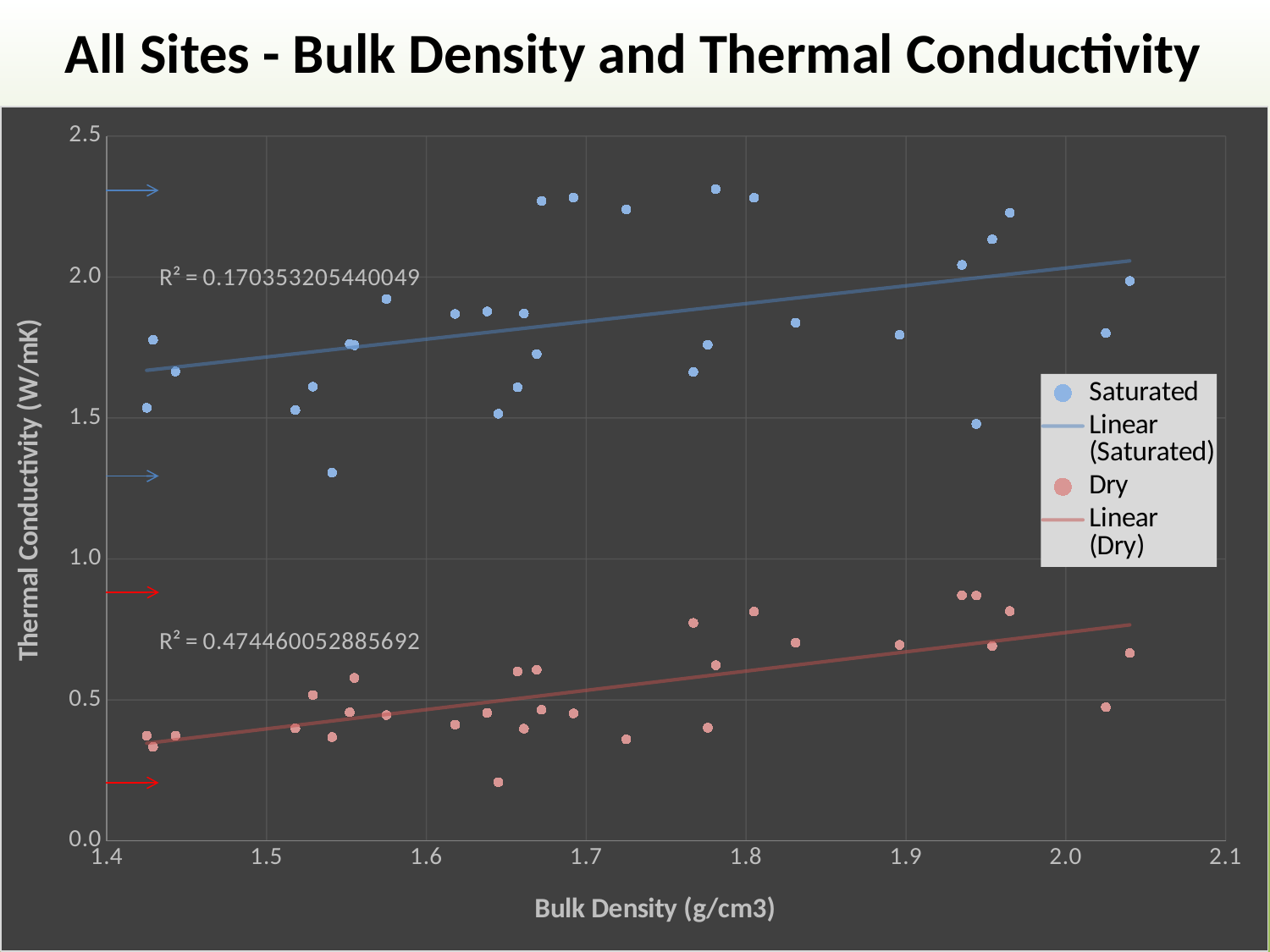
What is the title of the chart's x axis? Bulk Density (g/cm3) Which series has the higher R² value, Saturated or Dry? Dry What is the R² value shown for the Dry trendline? 0.474460052885692 Does the Linear (Saturated) trendline rise or fall as bulk density increases? Rises Is the lowest Dry thermal conductivity value greater or less than 0.5? less What is the R² value shown for the Saturated trendline? 0.170353205440049 How many entries does the legend list? 4 What is the title of the chart's y axis? Thermal Conductivity (W/mK) Does the Linear (Dry) trendline rise or fall as bulk density increases? Rises What is the difference between the Dry R² value and the Saturated R² value? 0.304106847445643 What kind of chart is shown on the slide? Scatter chart Is the highest Saturated thermal conductivity value greater or less than 2.0? greater